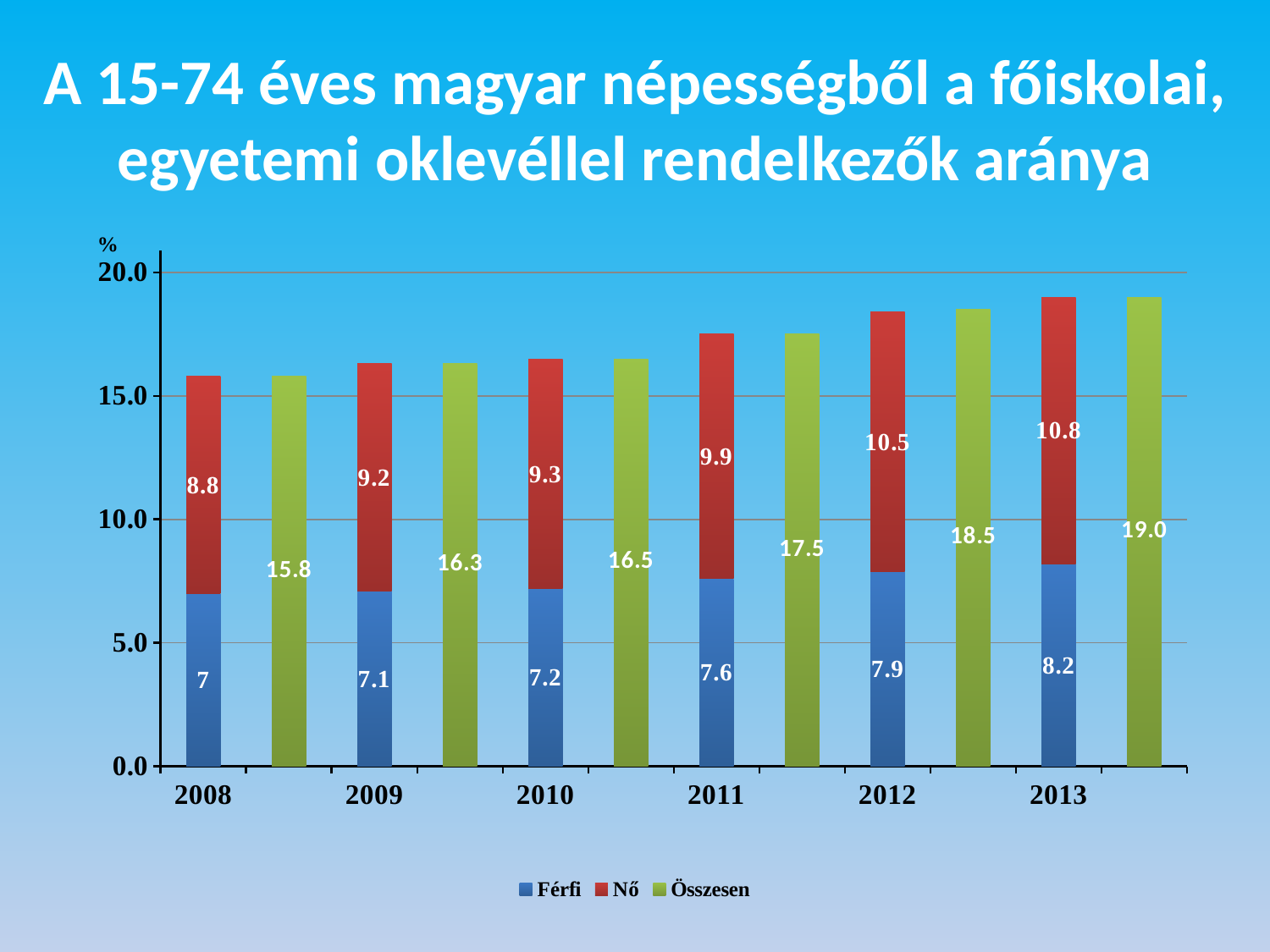
In which year is the Férfi value lowest? 2008 What is the difference between the Nő values for 2013 and 2008? 2.0 Do the Összesen values rise or fall from 2008 to 2013? Rise What is the value for Összesen in 2009? 16.3 Is the Összesen value for 2012 greater or less than 15.0? greater What is the value for Férfi in 2013? 8.2 What is the value for Nő in 2011? 9.9 What kind of chart is shown on the slide? Stacked bar chart How many years are shown on the x axis? 6 How many series does the legend list? 3 In which year is the Összesen value highest? 2013 Which is larger, the Nő value in 2010 or the Férfi value in 2010? Nő